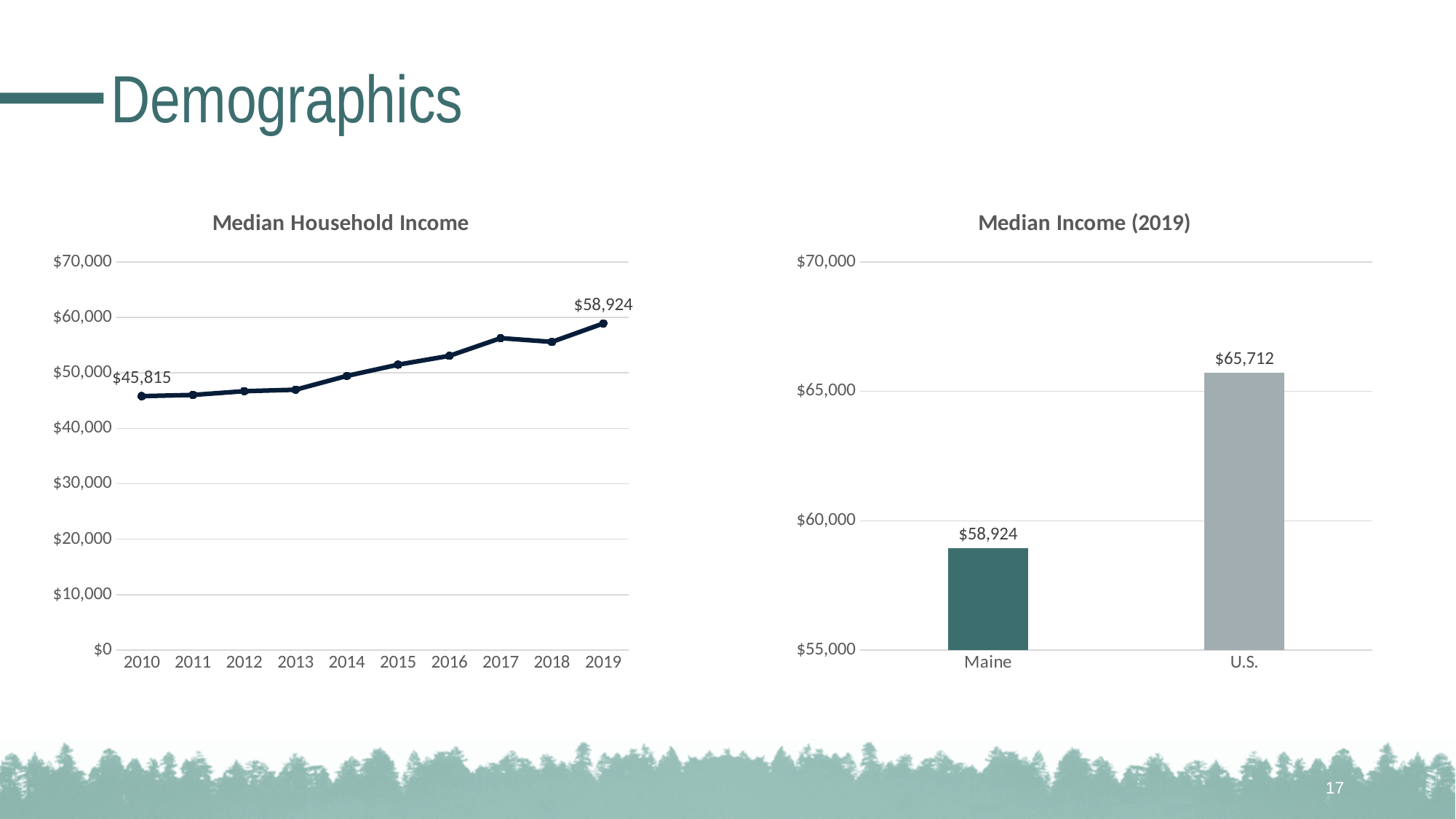
How many years are plotted in the Median Household Income chart? 10 In the Median Household Income chart, do values generally rise or fall from 2010 to 2019? rise In the Median Household Income chart, what is the value for 2019? $58,924 In the Median Income (2019) chart, what is the value for U.S.? $65,712 In the Median Household Income chart, is the value for 2015 greater or less than $50,000? greater In the Median Household Income chart, is the value for 2013 greater or less than $50,000? less In the Median Income (2019) chart, which category has the higher value, Maine or U.S.? U.S. In the Median Household Income chart, what is the value for 2010? $45,815 What kind of chart is the Median Income (2019) chart? bar chart What kind of chart is the Median Household Income chart? line chart In the Median Household Income chart, what is the difference between the 2019 and 2010 values? $13,109 In the Median Income (2019) chart, what is the difference between the U.S. and Maine values? $6,788